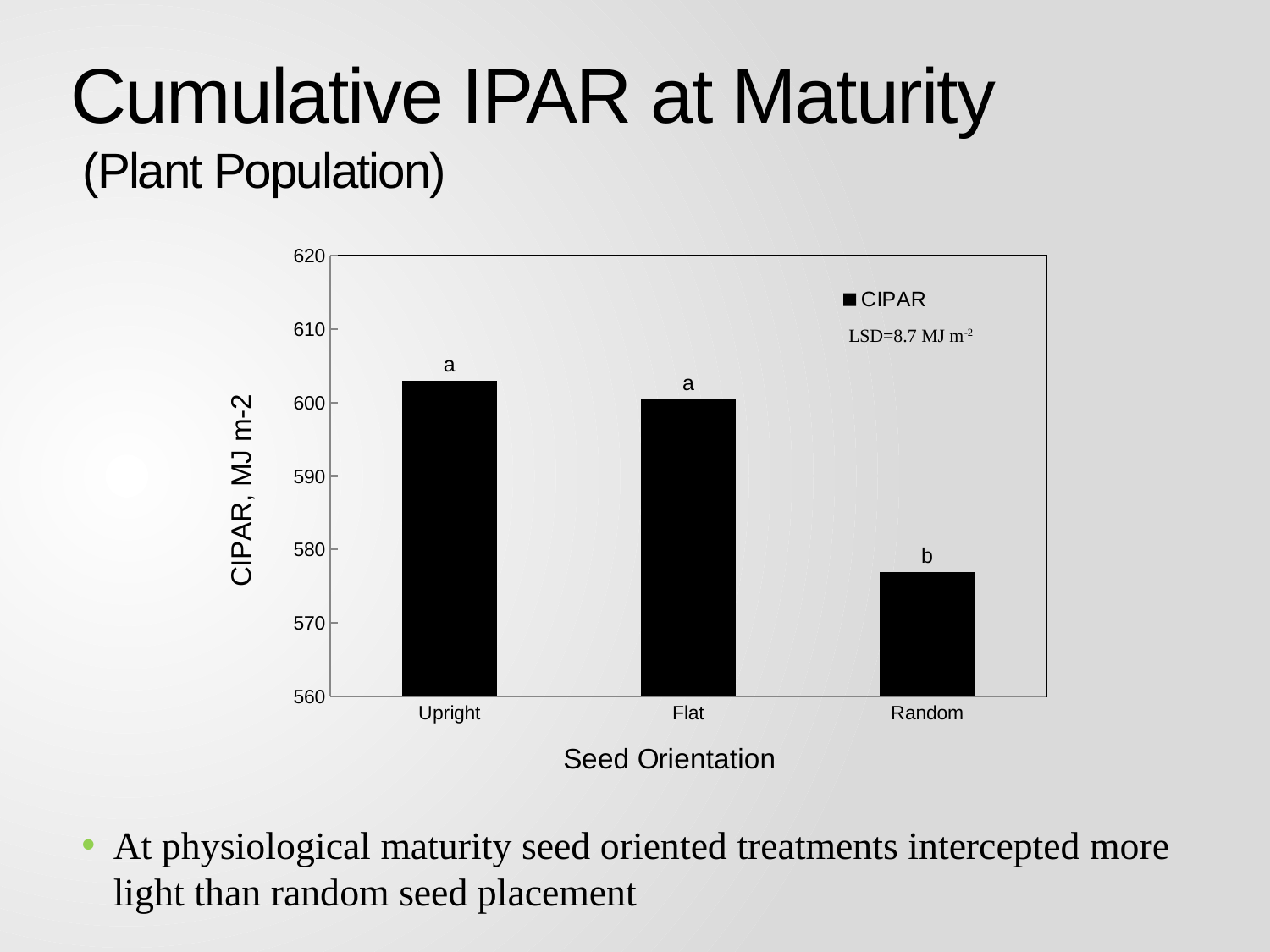
Which seed orientation has the lowest CIPAR value? Random Is the CIPAR value for Random greater or less than 570? greater Which has the larger CIPAR value, Flat or Random? Flat Is the CIPAR value for Upright greater or less than 610? less How many seed orientation categories are plotted on the x axis? 3 What is the title of the x axis? Seed Orientation Do the CIPAR values rise or fall moving from Upright to Random along the x axis? fall Is the CIPAR value for Random greater or less than 580? less How many series does the legend list? 1 What is the LSD value stated on the chart? LSD=8.7 MJ m-2 What kind of chart is shown on the slide? bar chart